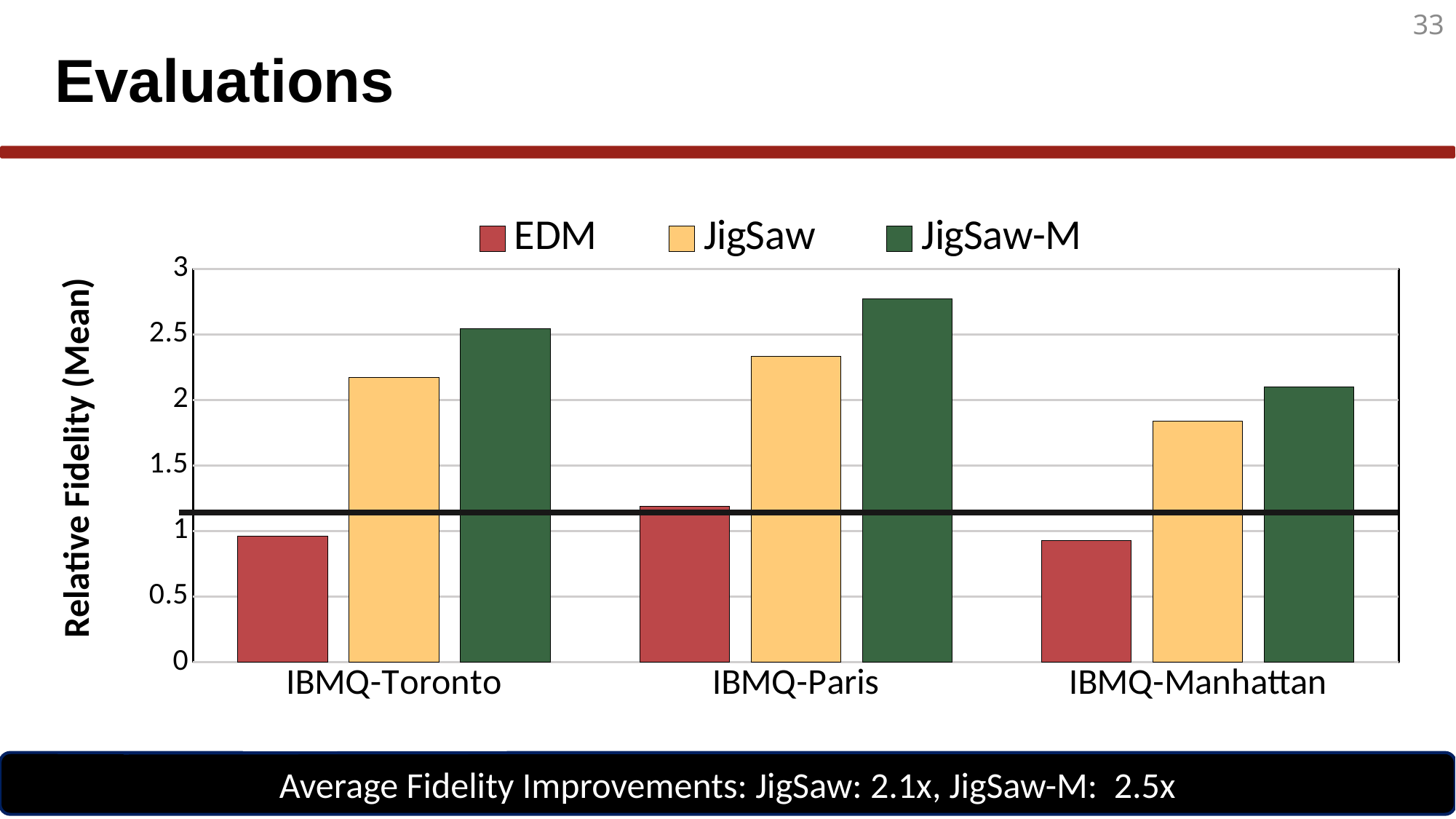
What is the label of the y axis? Relative Fidelity (Mean) Which device has the lowest JigSaw bar? IBMQ-Manhattan Which is larger: the JigSaw-M value for IBMQ-Toronto or the JigSaw-M value for IBMQ-Manhattan? IBMQ-Toronto Is the JigSaw value for IBMQ-Toronto greater or less than 2? greater How many series does the legend list? 3 Which device has the highest JigSaw bar? IBMQ-Paris How many device categories are shown on the x axis? 3 Is the EDM value for IBMQ-Paris greater or less than 1? greater Is the JigSaw value for IBMQ-Manhattan greater or less than 2? less Which device has the highest JigSaw-M bar? IBMQ-Paris What kind of chart is shown on the slide? bar chart